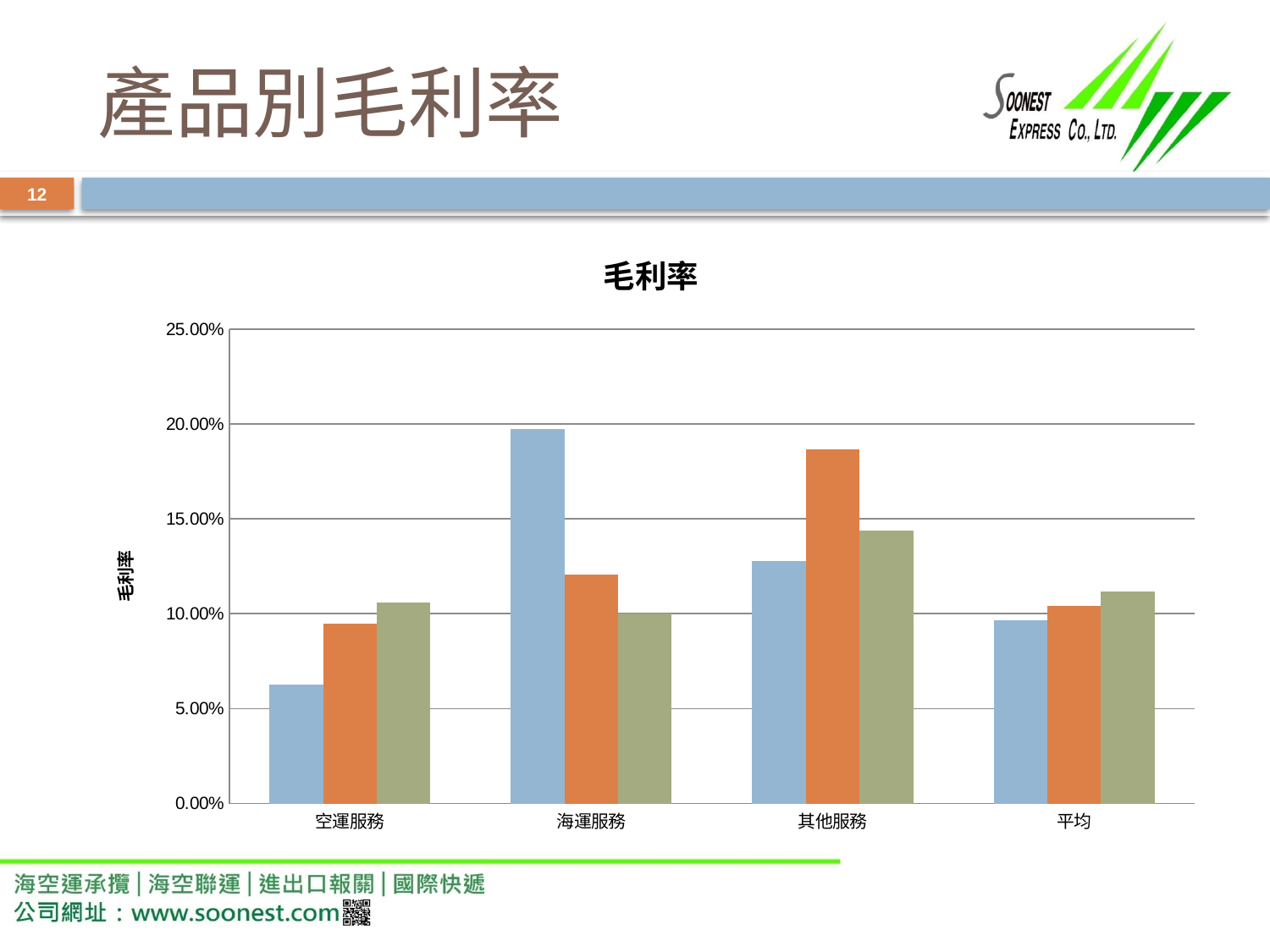
Is the value of the green bar for 平均 greater or less than 10.00%? greater Is the value of the green bar for 其他服務 greater or less than 15.00%? less Among the blue bars, which category has the highest value? 海運服務 For 海運服務, which is larger: the blue bar or the orange bar? the blue bar What is the title of the chart? 毛利率 Among the blue bars, which category has the lowest value? 空運服務 Is the value of the blue bar for 海運服務 greater or less than 15.00%? greater How many categories are shown on the x axis of the chart? 4 How many bars are plotted for each category in the chart? 3 What kind of chart is shown on the slide? bar chart